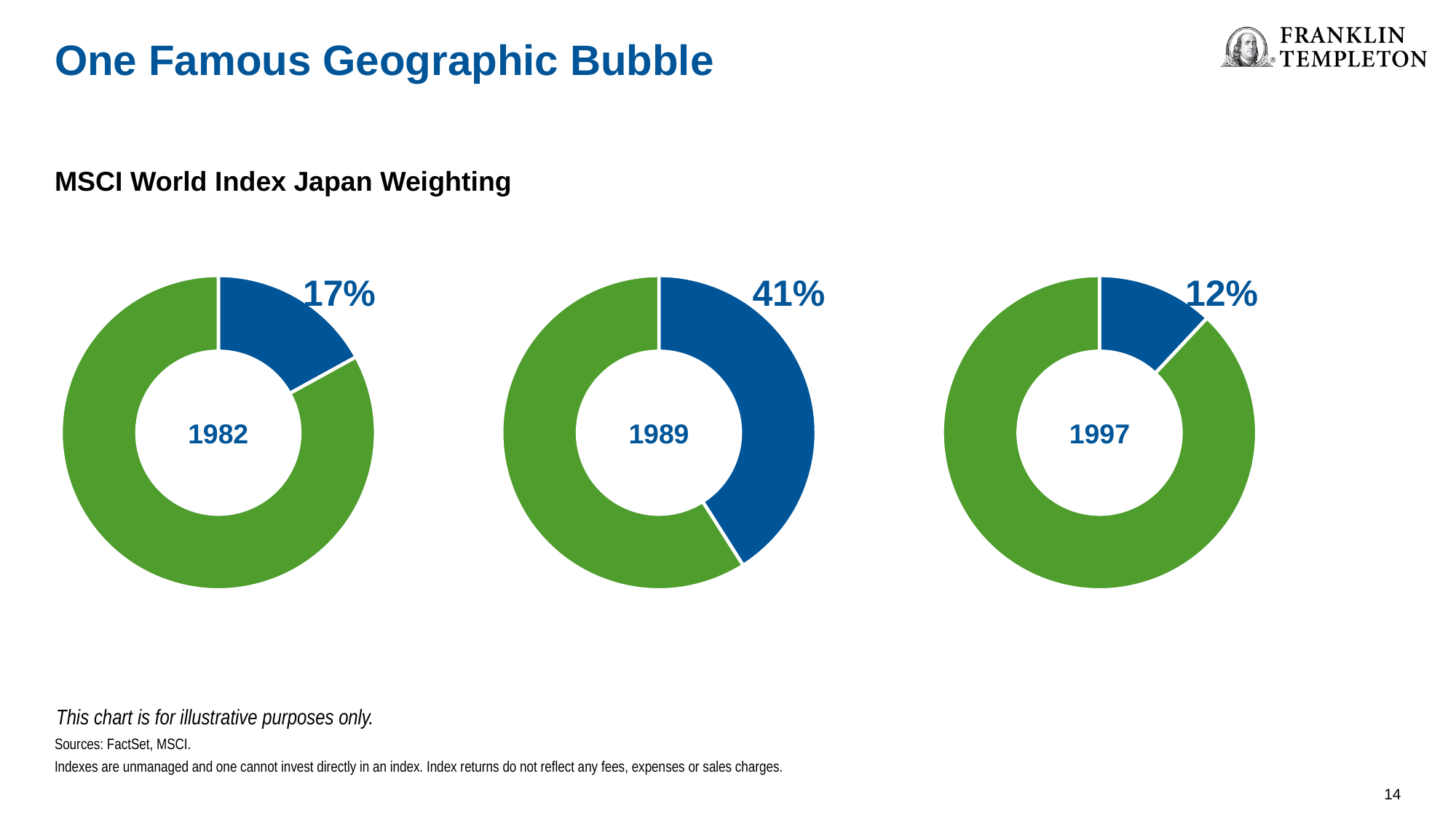
Across the three donut charts, which year shows the lowest Japan weighting? 1997 What kind of chart is used to show the Japan weighting for each year? Donut (pie) chart In the 1989 donut chart, what is the Japan weighting shown? 41% What is the difference between the Japan weighting in the 1989 chart and the 1982 chart? 24 percentage points In the 1982 donut chart, what is the Japan weighting shown? 17% Across the three donut charts, which year shows the highest Japan weighting? 1989 How many donut charts are shown on the slide? 3 What colour is the Japan weighting slice in each donut chart? Blue Does the Japan weighting rise or fall from the 1989 chart to the 1997 chart? Fall In the 1997 donut chart, what is the Japan weighting shown? 12% What is the difference between the Japan weighting in the 1989 chart and the 1997 chart? 29 percentage points Is the Japan weighting larger in the 1982 chart or the 1997 chart? 1982